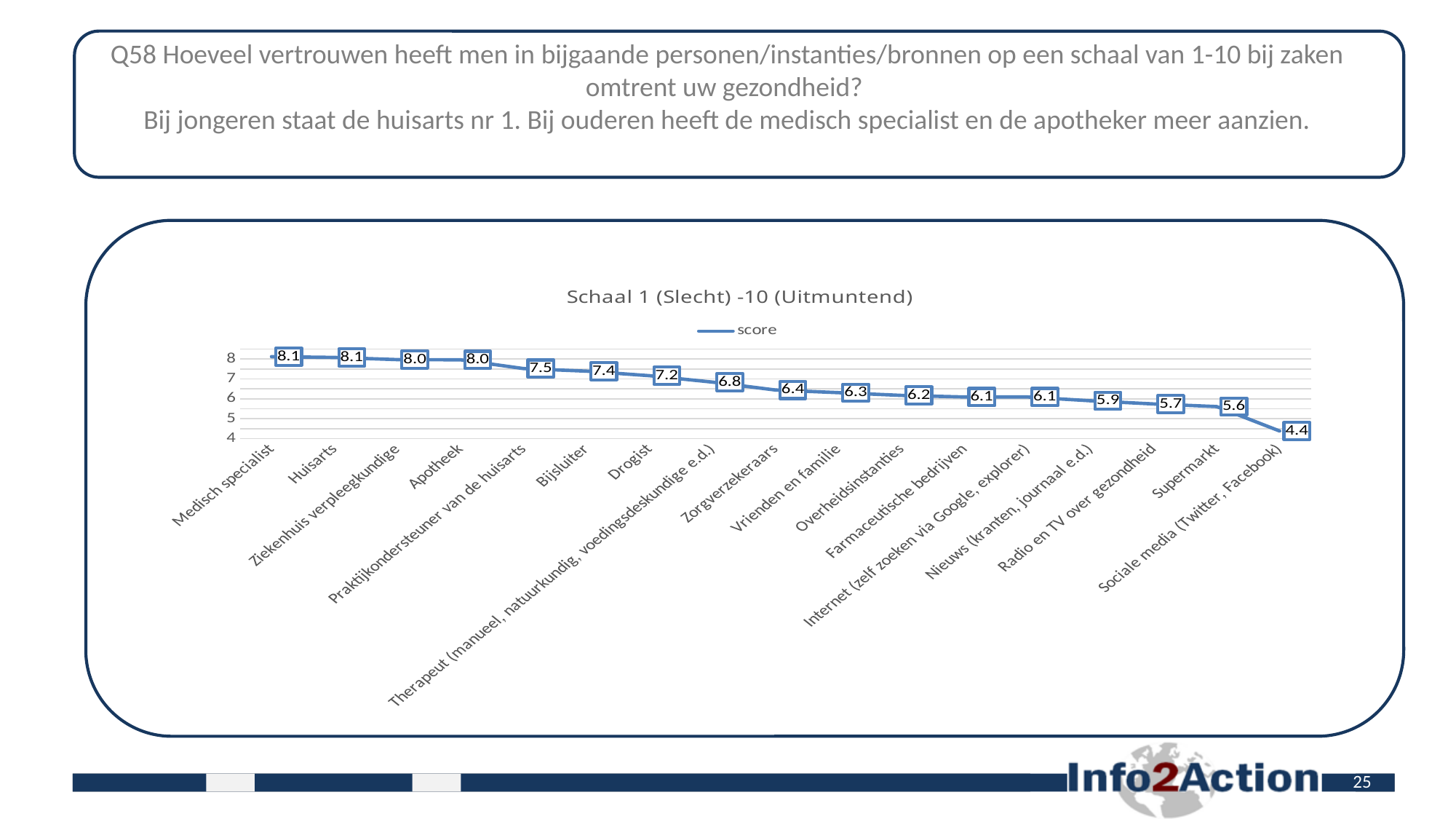
What kind of chart is shown on the slide? Line chart What is the score for Huisarts? 8.1 What is the score for Zorgverzekeraars? 6.4 How many series does the legend list? 1 What is the score for Bijsluiter? 7.4 Which has a higher score, Drogist or Overheidsinstanties? Drogist Which category has the lowest score? Sociale media (Twitter , Facebook) How many categories are plotted on the chart? 17 Do the scores rise or fall from left to right along the x axis? Fall What is the score for Supermarkt? 5.6 What is the difference between the score for Medisch specialist and the score for Sociale media (Twitter , Facebook)? 3.7 What is the title of the chart? Schaal 1 (Slecht) -10 (Uitmuntend)